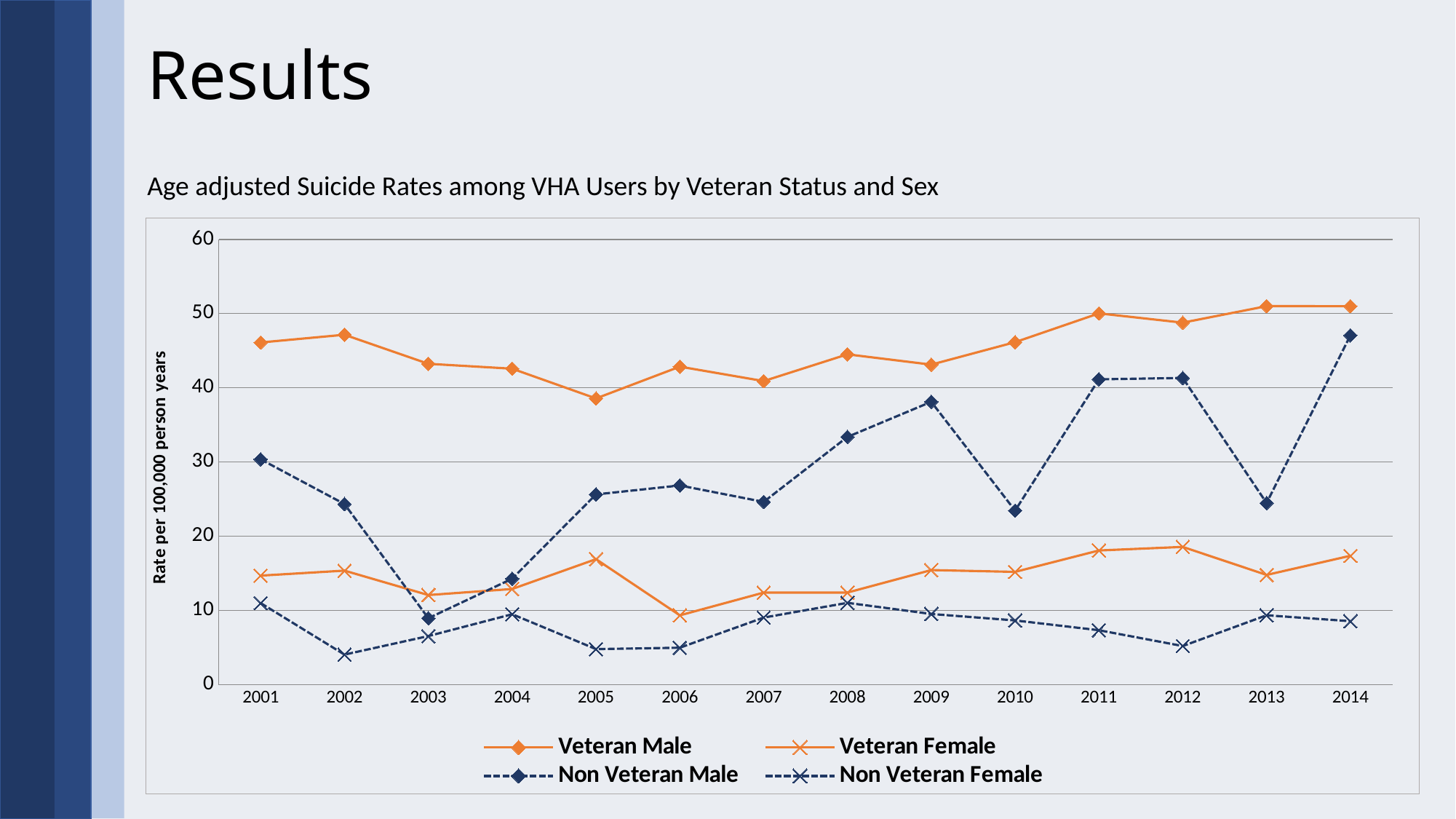
In which year is the Non Veteran Male rate highest? 2014 Is the value for Non Veteran Male in 2009 greater or less than 30? greater In 2010, which is larger: Veteran Male or Non Veteran Male? Veteran Male Is the value for Veteran Male in 2001 greater or less than 40? greater In 2012, which is larger: Veteran Female or Non Veteran Female? Veteran Female What is the label on the y axis? Rate per 100,000 person years In which year is the Veteran Male rate lowest? 2005 How many years are plotted along the x axis? 14 What kind of chart is shown on the slide? line chart Is the value for Non Veteran Male in 2014 greater or less than 40? greater How many series does the legend list? 4